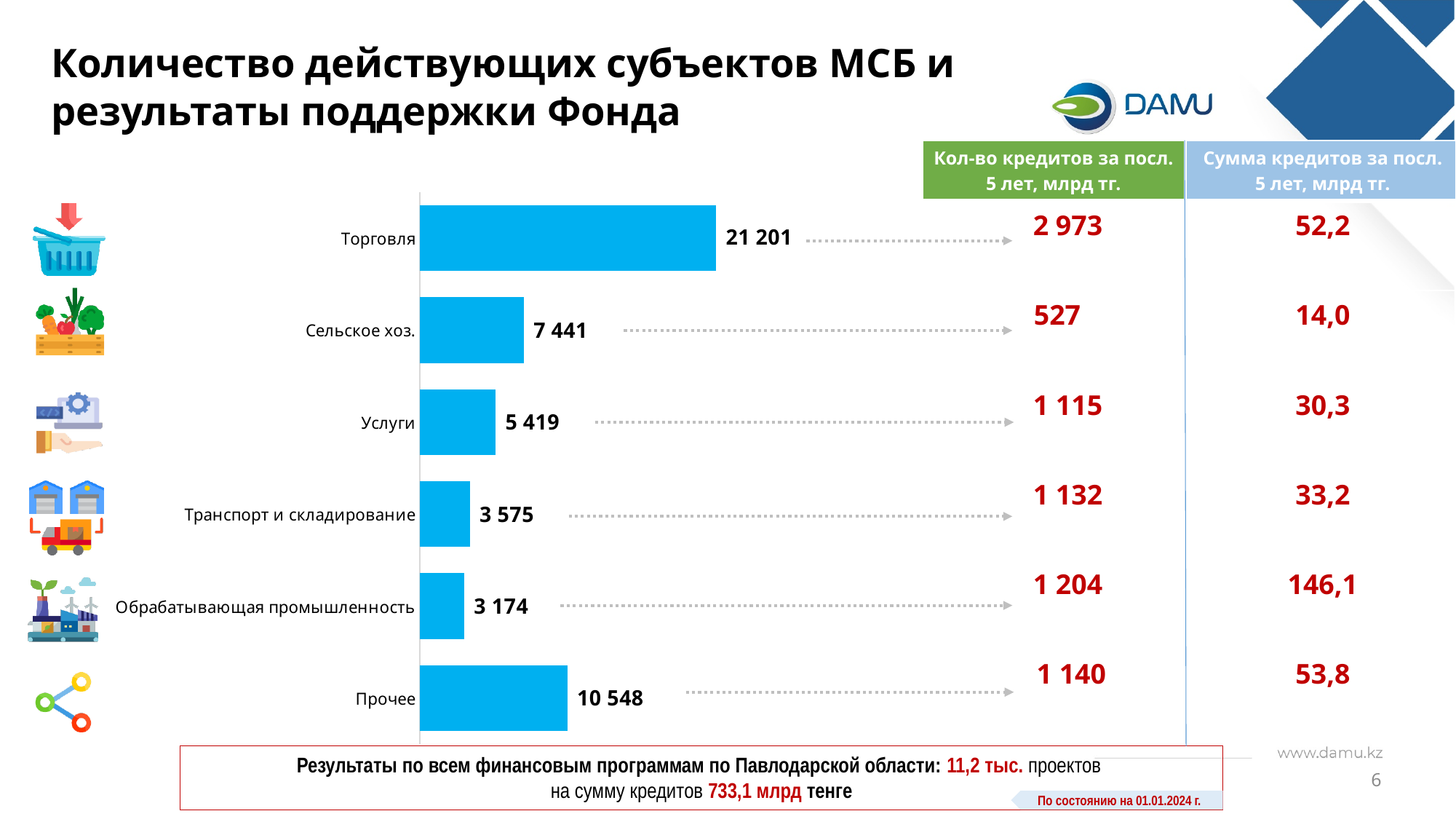
What is the difference between the values for Торговля and Прочее in the bar chart? 10 653 What is the value shown for Прочее in the bar chart? 10 548 Which category has the lowest value in the bar chart? Обрабатывающая промышленность What is the value shown for Обрабатывающая промышленность in the bar chart? 3 174 How many categories are shown in the bar chart? 6 What colour are the bars in the chart? Blue Which category has the highest value in the bar chart? Торговля Which is larger in the bar chart: the value for Услуги or the value for Транспорт и складирование? Услуги What is the value shown for Сельское хоз. in the bar chart? 7 441 What is the value shown for Торговля in the bar chart? 21 201 What kind of chart is shown on the slide? Bar chart What is the difference between the values for Сельское хоз. and Услуги in the bar chart? 2 022